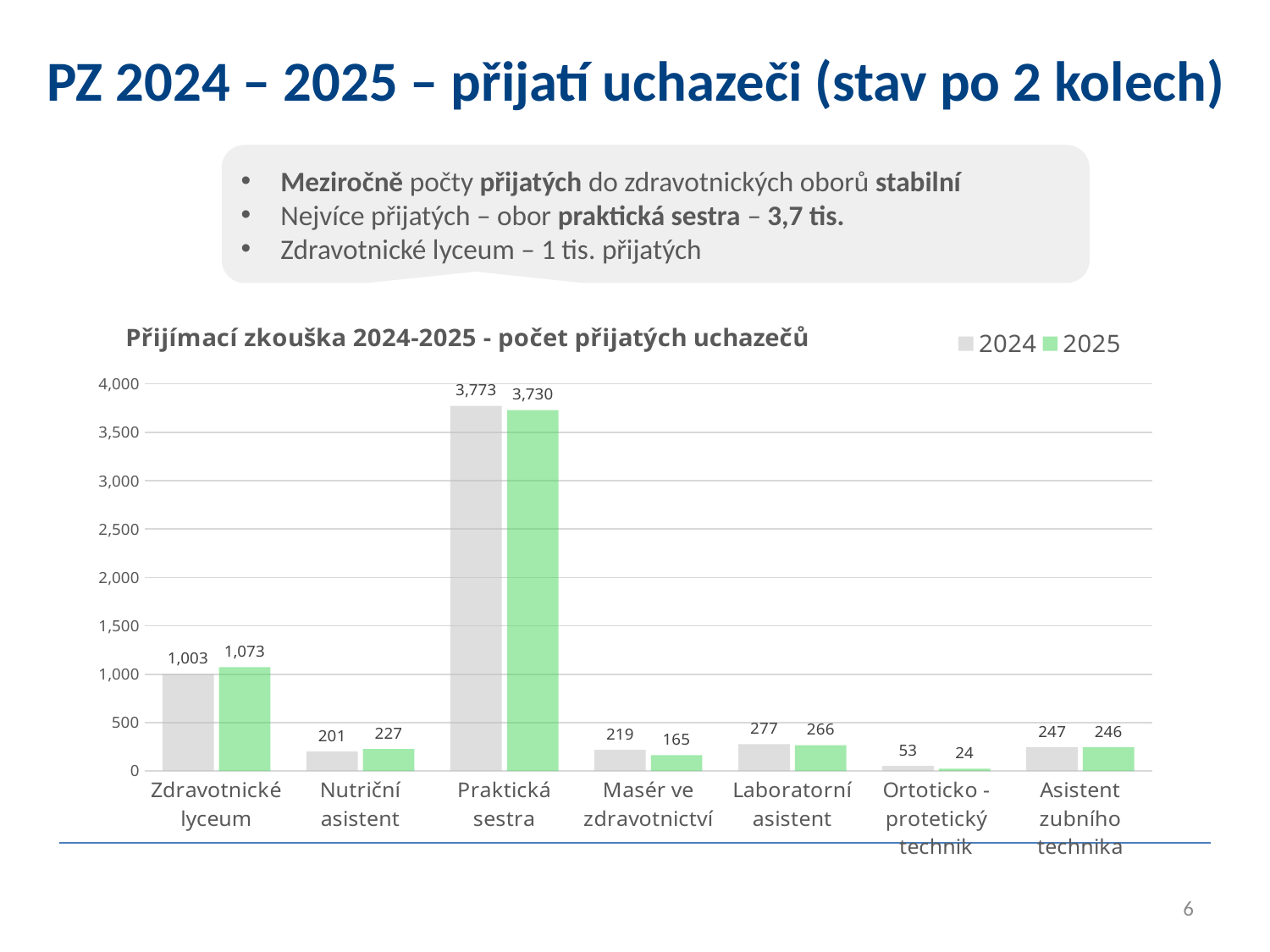
What is the difference between the 2024 and 2025 values for Zdravotnické lyceum? 70 What is the 2024 value for Zdravotnické lyceum? 1,003 Is the 2025 value for Laboratorní asistent greater or less than 500? less How many series does the legend list? 2 Which category has the lowest 2025 value? Ortoticko - protetický technik What is the 2025 value for Praktická sestra? 3,730 What is the difference between the 2024 and 2025 values for Masér ve zdravotnictví? 54 Which is larger for Nutriční asistent, the 2024 value or the 2025 value? 2025 What kind of chart is shown? bar chart What is the 2025 value for Ortoticko - protetický technik? 24 How many categories are shown on the x axis? 7 Which category has the highest 2024 value? Praktická sestra